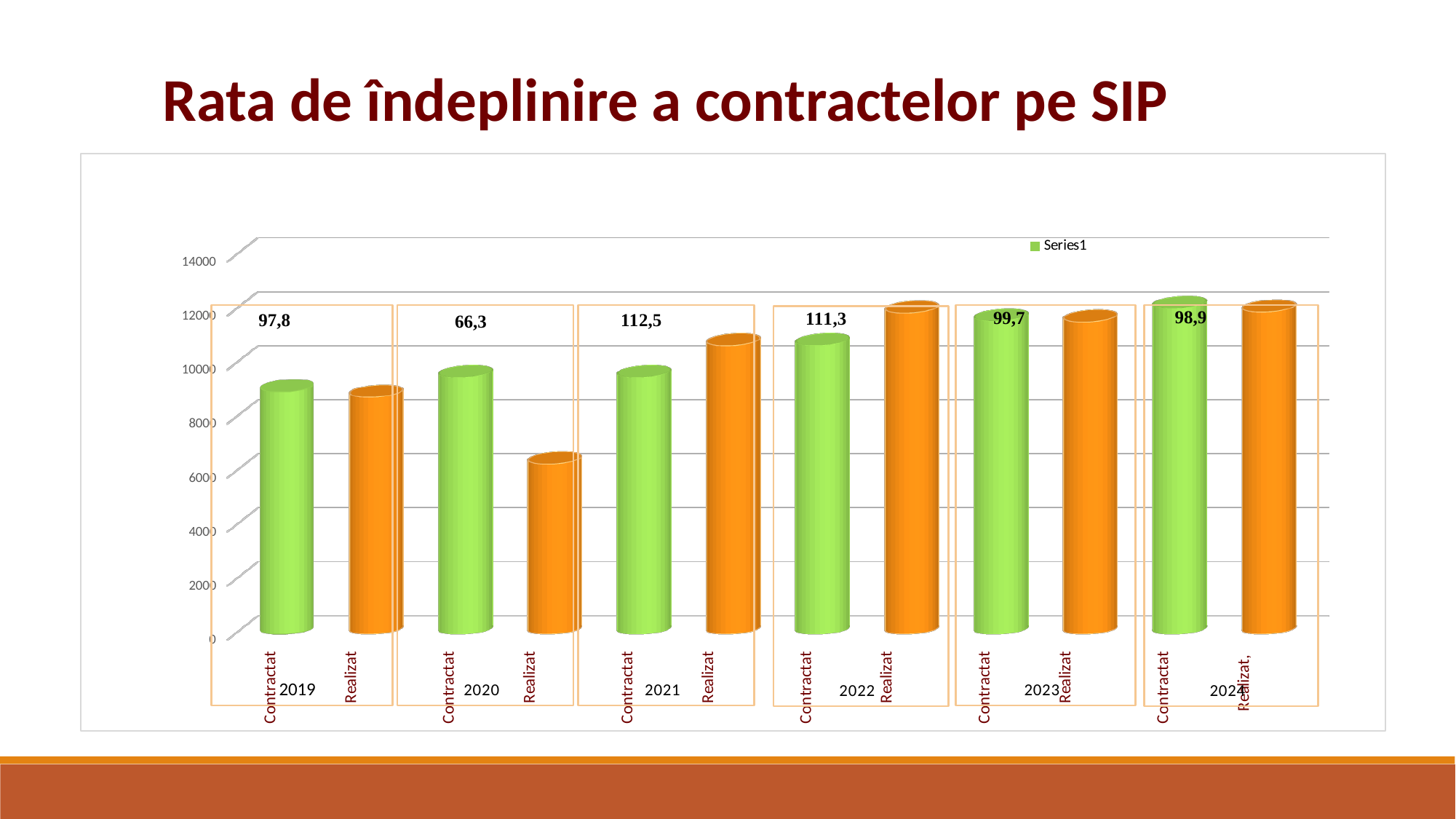
Is the Realizat value for 2020 greater or less than 8000? less How many years are shown on the x axis of the chart? 6 What rate is printed above the 2019 bars? 97,8 How many series does the chart legend list? 1 What kind of chart is shown on the slide? bar chart Is the Contractat value for 2019 greater or less than 8000? greater What rate is printed above the 2020 bars? 66,3 Which year has the lowest printed rate? 2020 What is the title of the slide? Rata de îndeplinire a contractelor pe SIP Which year has the highest printed rate? 2021 What rate is printed above the 2023 bars? 99,7 For 2020, which is larger, Contractat or Realizat? Contractat